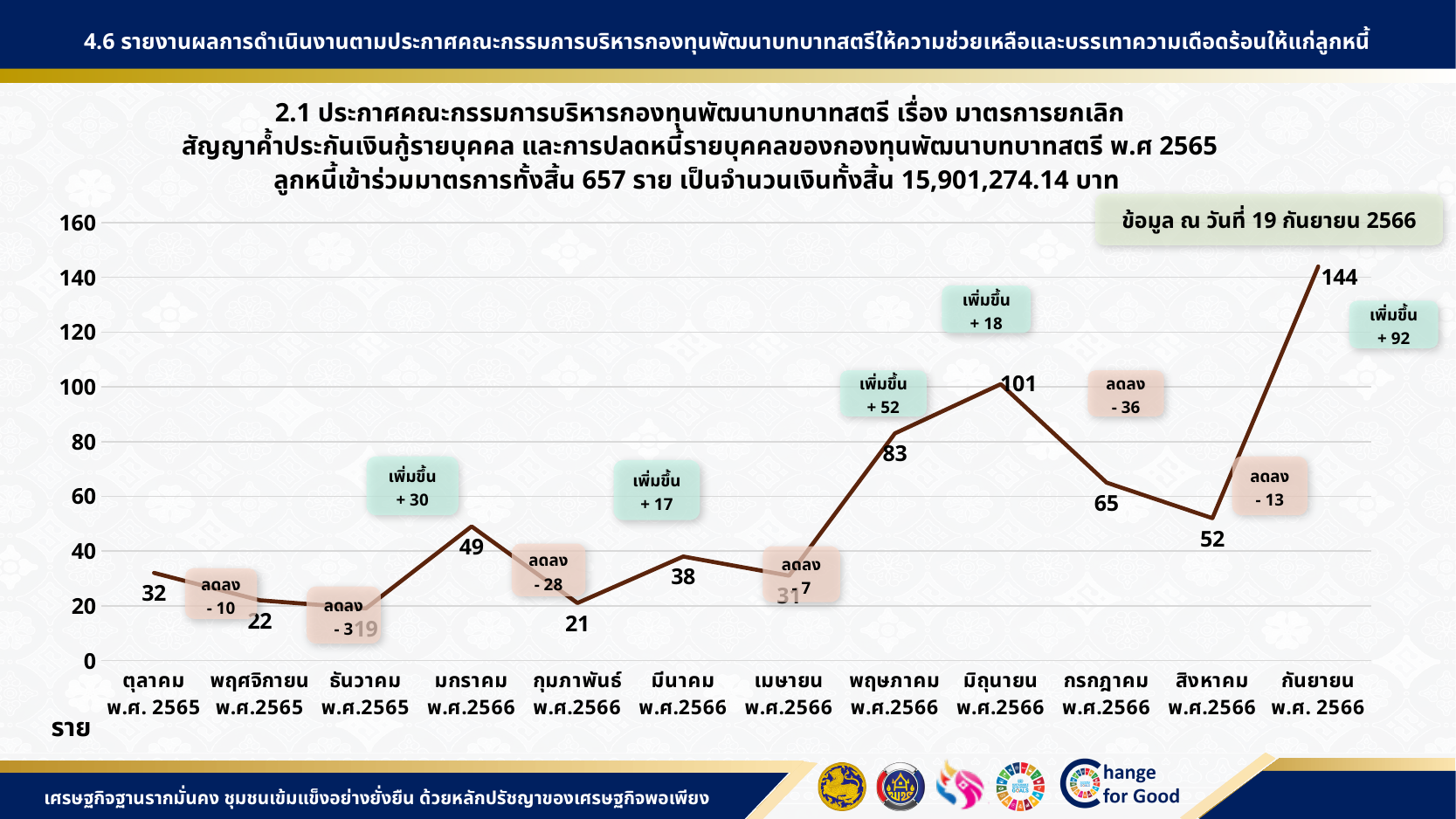
What is the total number of debtors (ลูกหนี้) stated in the chart title? 657 ราย How many months are plotted on the chart? 12 What is the value for มกราคม พ.ศ.2566? 49 What is the value for กันยายน พ.ศ. 2566? 144 What is the value for มิถุนายน พ.ศ.2566? 101 What is the value for ตุลาคม พ.ศ. 2565? 32 What kind of chart is shown on the slide? Line chart Which month has the highest value? กันยายน พ.ศ. 2566 Which is larger, the value for พฤษภาคม พ.ศ.2566 or the value for กรกฎาคม พ.ศ.2566? พฤษภาคม พ.ศ.2566 What is the difference between the values for กันยายน พ.ศ. 2566 and สิงหาคม พ.ศ.2566? 92 Which month has the lowest value? ธันวาคม พ.ศ.2565 Does the value rise or fall from สิงหาคม พ.ศ.2566 to กันยายน พ.ศ. 2566? Rise